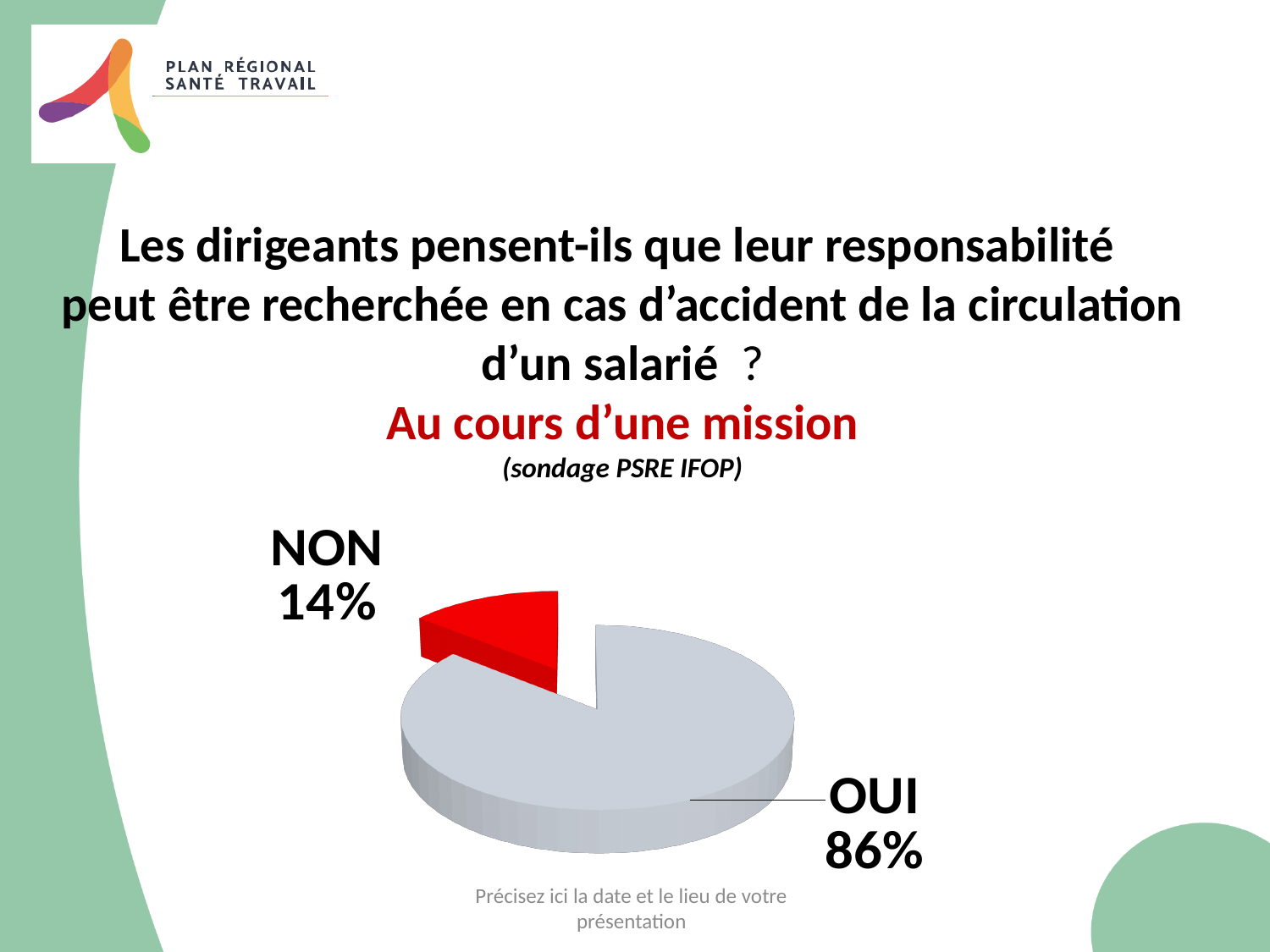
Which survey is cited as the source of the chart data? sondage PSRE IFOP What is the difference in percentage points between the OUI and NON slices? 72 What kind of chart is shown on the slide? Pie chart What share of the pie does the OUI slice represent? 86% What colour is the NON slice of the pie chart? Red Which is larger, the OUI slice or the NON slice? OUI How many slices does the pie chart have? 2 Which slice of the pie is the smallest? NON Which slice of the pie is the largest? OUI What is the total of the two slice percentages shown on the pie chart? 100% What share of the pie does the NON slice represent? 14%